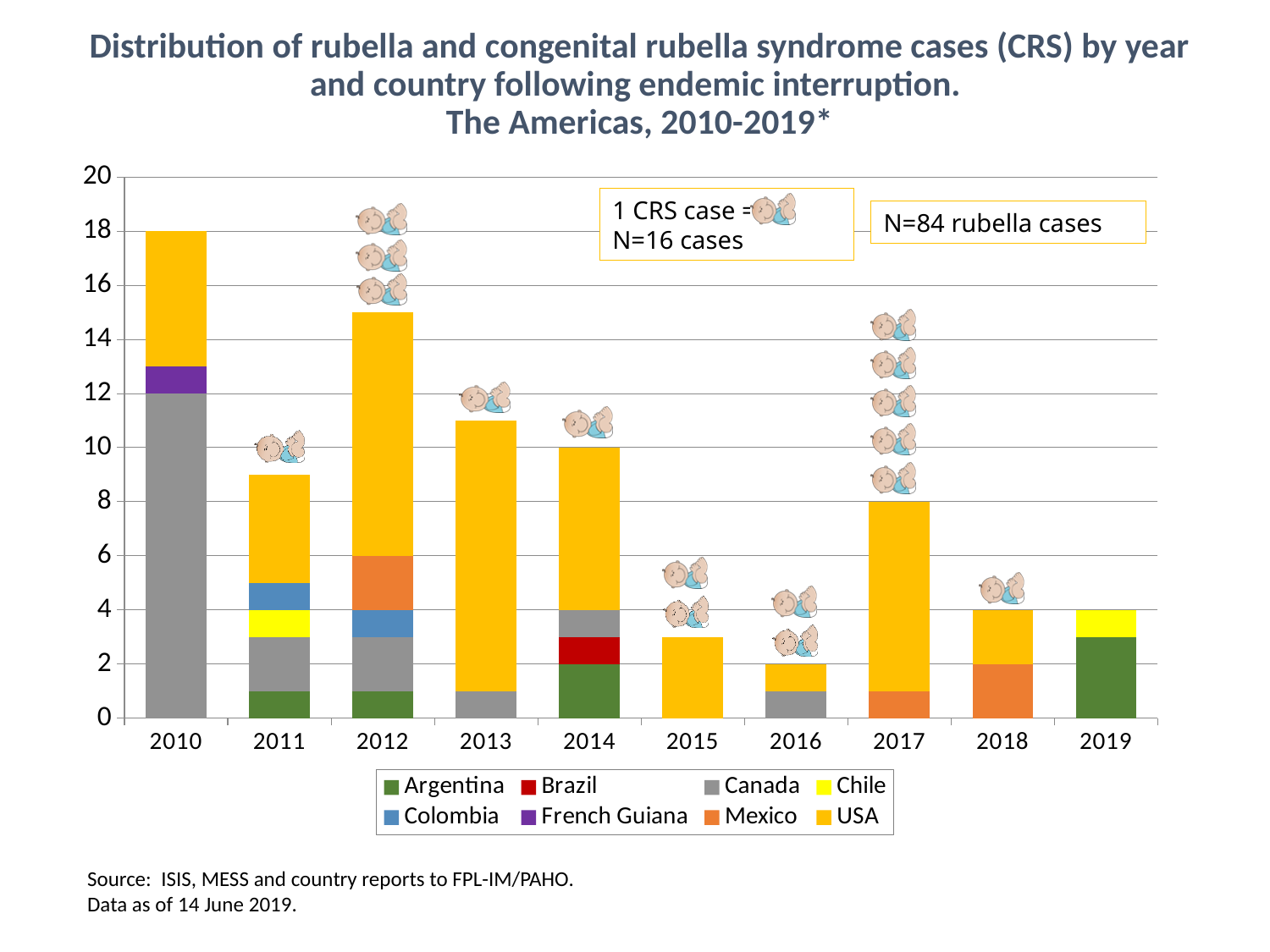
How many countries does the legend list? 8 Which year has the lowest total number of rubella cases? 2016 Which year has more rubella cases, 2014 or 2015? 2014 Which year has the highest total number of rubella cases? 2010 What is the total number of rubella cases in 2017? 8 According to the text box on the chart, what is the total number of rubella cases (N)? N=84 rubella cases What is the total number of rubella cases in 2010? 18 How many rubella cases does Canada account for in 2010? 12 Is the total number of rubella cases in 2012 greater or less than 14? greater What type of chart is shown on the slide? Stacked bar chart What is the difference between the total rubella cases in 2010 and in 2017? 10 How many years are shown on the x axis of the chart? 10